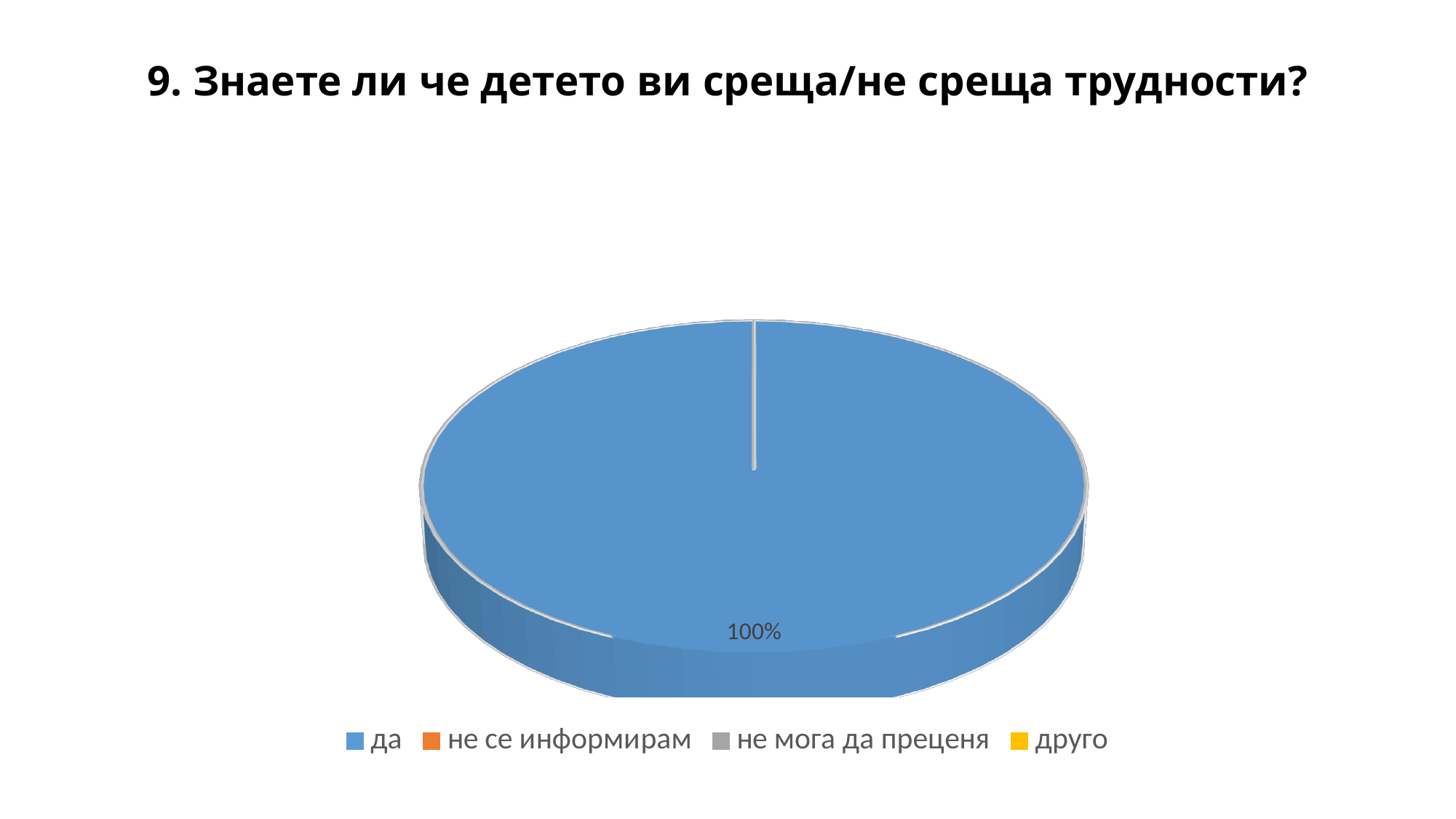
Is the share for "да" greater or less than 50%? greater What is the value printed on the pie chart? 100% Which category has the largest share of the pie? да What is the title of the chart? 9. Знаете ли че детето ви среща/не среща трудности? What share of the pie does the "да" slice take? 100% Which legend entry is shown in blue? да Which is larger, the share for "да" or the share for "друго"? да What kind of chart is shown on the slide? pie chart How many entries does the legend list? 4 How many slices are visible in the pie chart? 1